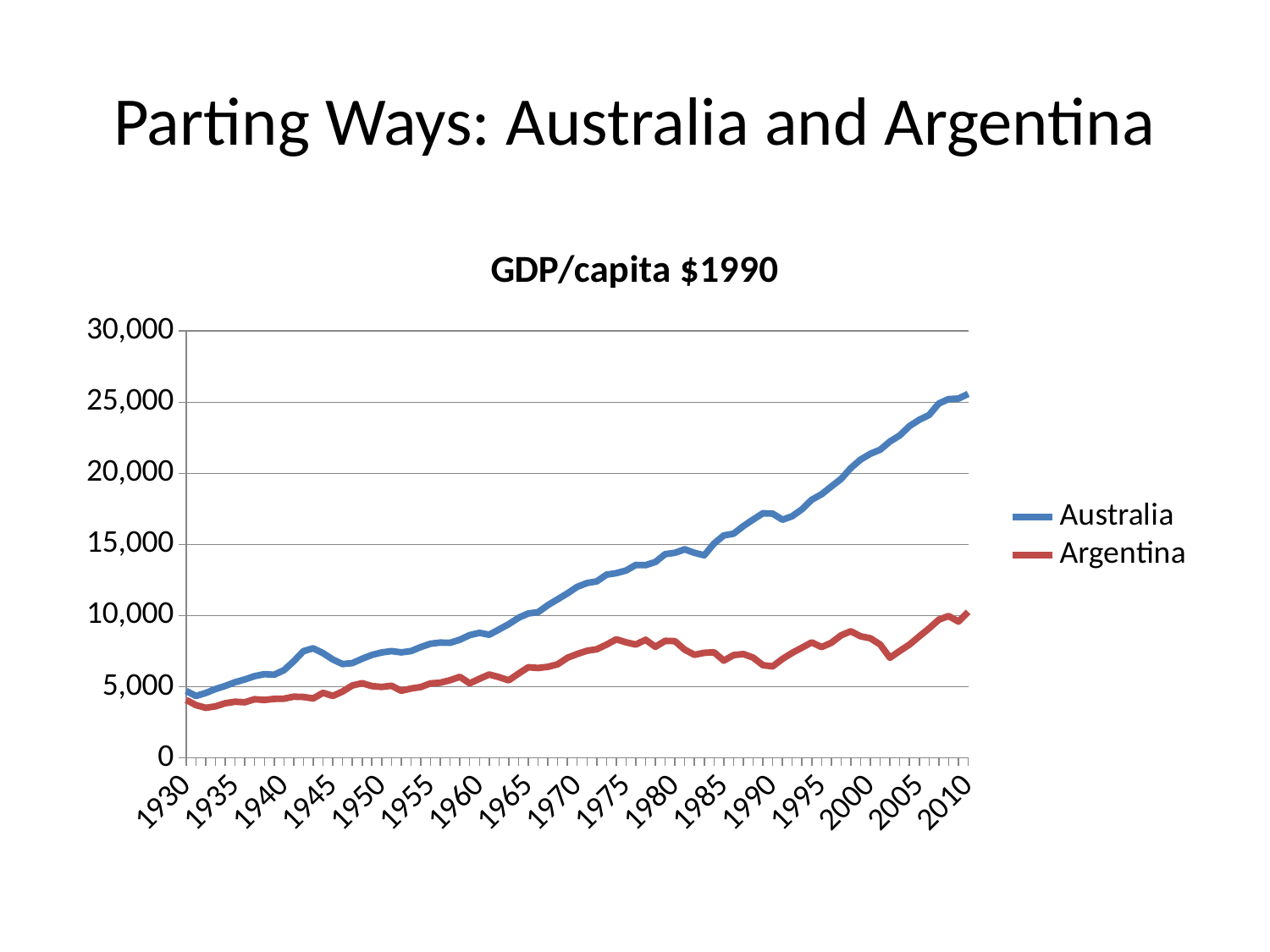
What kind of chart is shown on the slide? line chart Which series reaches the highest value on the chart? Australia How many series does the legend list? 2 Is the value for Argentina in 2010 greater or less than 15,000? less Is the value for Argentina in 1990 greater or less than 10,000? less Does the Australia series rise or fall overall from 1930 to 2010? rise Which two countries are listed in the legend? Australia and Argentina Is the value for Australia in 2010 greater or less than 20,000? greater What is the title of the chart? GDP/capita $1990 How many year labels are shown on the x axis? 17 Which series has the higher value in 2010, Australia or Argentina? Australia